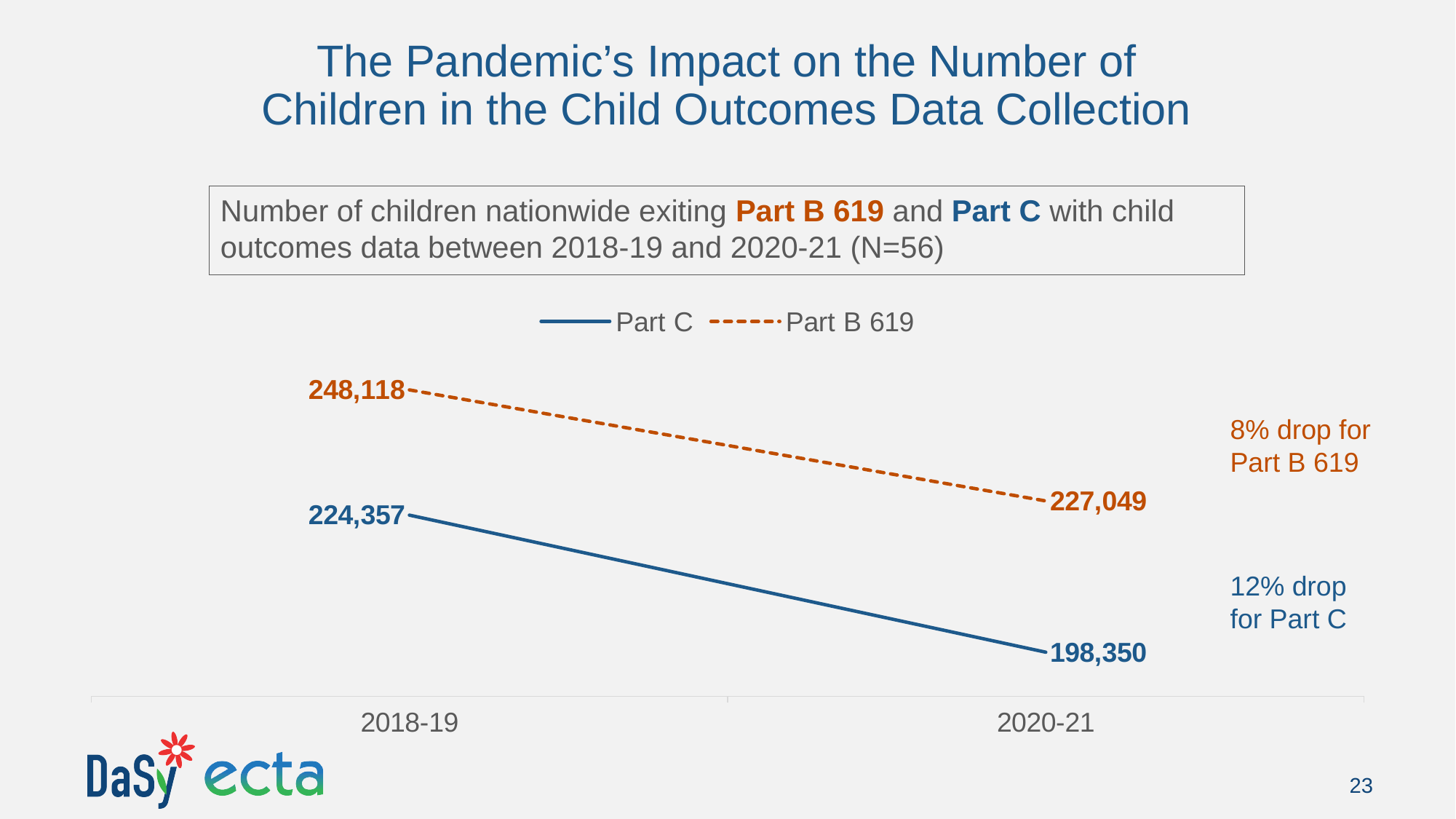
What was the number of children exiting Part B 619 in 2020-21? 227,049 What was the number of children exiting Part B 619 in 2018-19? 248,118 What percentage drop is noted for Part C on the slide? 12% Which series had the higher value in 2020-21, Part C or Part B 619? Part B 619 What was the number of children exiting Part C in 2018-19? 224,357 How many time periods are shown on the x axis? 2 How many series does the legend list? 2 What type of chart is shown on the slide? Line chart What was the number of children exiting Part C in 2020-21? 198,350 Do the values for Part C rise or fall from 2018-19 to 2020-21? Fall By how much did the Part B 619 value decrease from 2018-19 to 2020-21? 21,069 By how much did the Part C value decrease from 2018-19 to 2020-21? 26,007